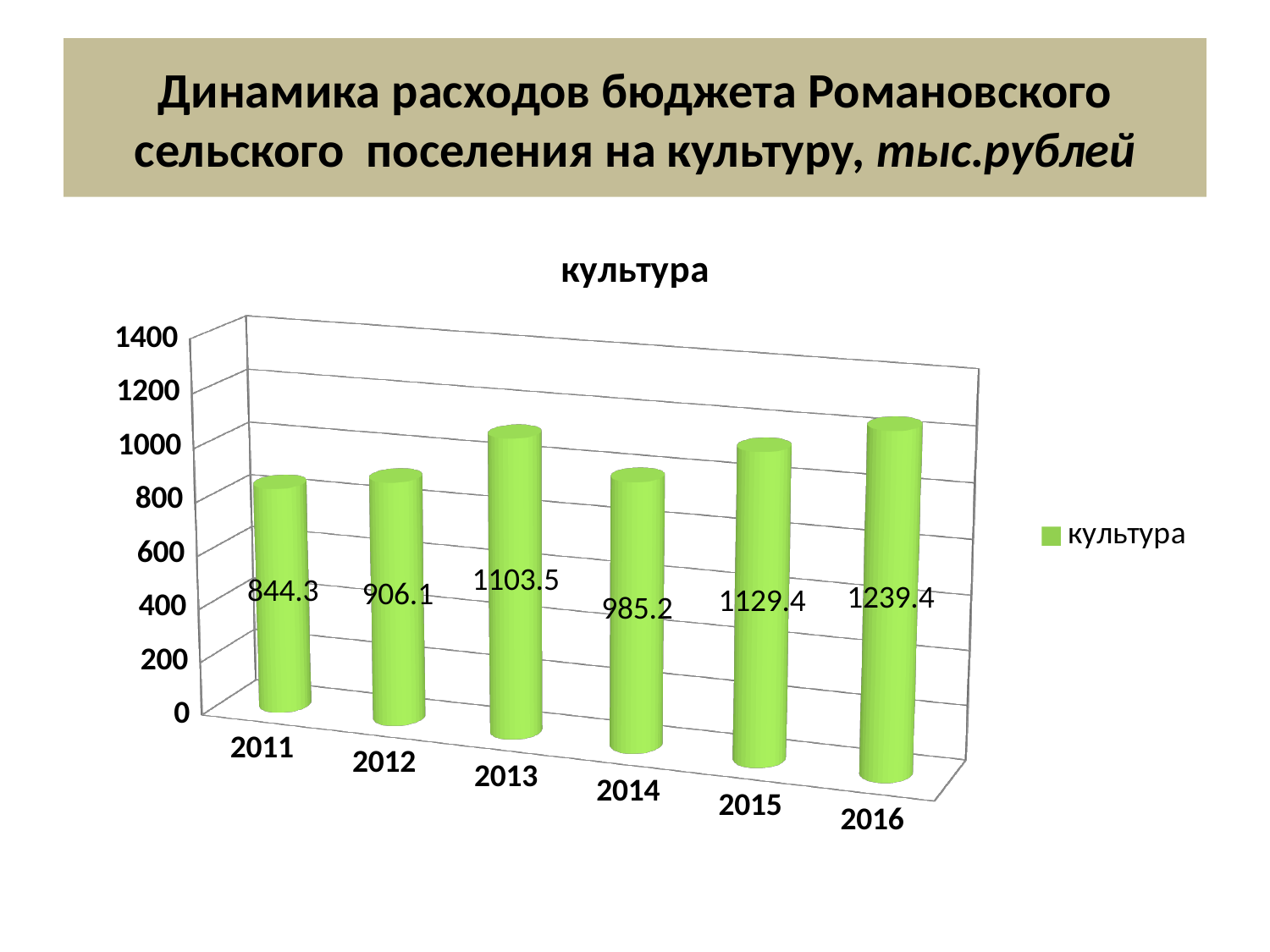
What is the value for 2016? 1239.4 What kind of chart is this? bar chart Which year has the lowest value? 2011 How many series does the legend list? 1 What is the title of the chart? культура What is the value for 2011? 844.3 Which is larger, the value for 2013 or the value for 2014? 2013 Which year has the highest value? 2016 How many years are shown on the x axis? 6 What is the difference between the values for 2013 and 2014? 118.3 What is the value for 2014? 985.2 What is the difference between the values for 2016 and 2011? 395.1